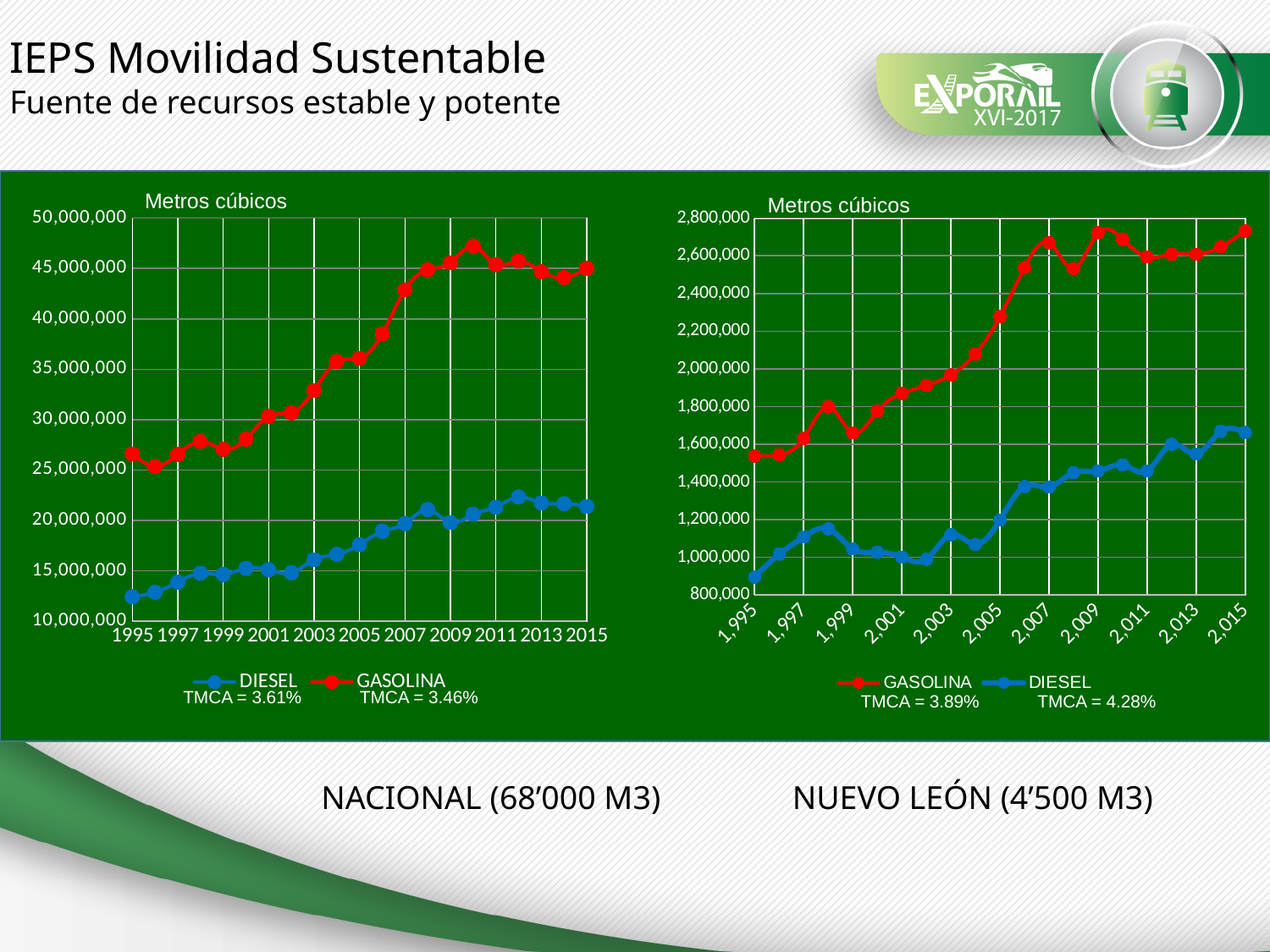
What TMCA value is shown for DIESEL under the right chart (NUEVO LEÓN)? 4.28% In the left chart (NACIONAL), is the GASOLINA value for 2015 greater or less than 40,000,000? greater How many series does the legend of the left chart (NACIONAL) list? 2 What are the two series named in the legend of the right chart (NUEVO LEÓN)? GASOLINA and DIESEL In the right chart (NUEVO LEÓN), does the GASOLINA series generally rise or fall from 1995 to 2015? rise In the right chart (NUEVO LEÓN), which series has the larger value in 2007, GASOLINA or DIESEL? GASOLINA In the right chart (NUEVO LEÓN), is the GASOLINA value for 2015 greater or less than 2,600,000? greater In the right chart (NUEVO LEÓN), is the DIESEL value for 1995 greater or less than 1,000,000? less In the left chart (NACIONAL), does the DIESEL series generally rise or fall from 1995 to 2015? rise In the left chart (NACIONAL), which series has the larger value in 2015, DIESEL or GASOLINA? GASOLINA What kind of chart is the left chart (NACIONAL)? line chart